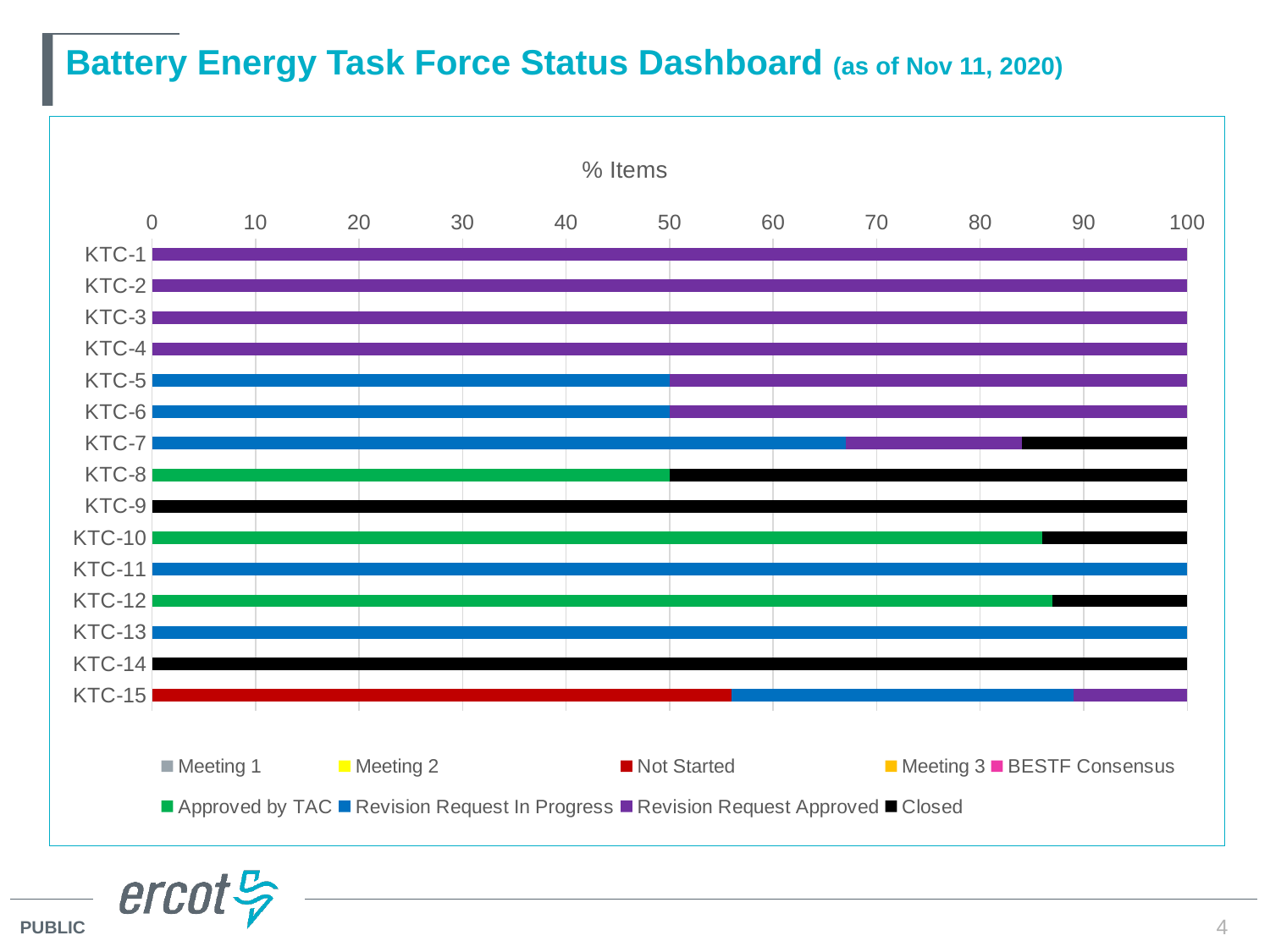
What value does the Approved by TAC segment for KTC-8 end at? 50 Is the Revision Request In Progress value for KTC-7 greater or less than 60? greater For KTC-15, which is larger: the Not Started segment or the Revision Request In Progress segment? Not Started How many series does the legend list? 9 How many KTC categories are plotted on the chart? 15 Which colour represents the Closed series in the legend? Black What value does the Revision Request In Progress segment for KTC-5 end at? 50 Is the Approved by TAC value for KTC-10 greater or less than 80? greater Is the Closed value for KTC-12 greater or less than 20? less What is the total of the stacked bar for KTC-1? 100 What is the title of the chart? % Items What kind of chart is shown on the slide? Stacked bar chart